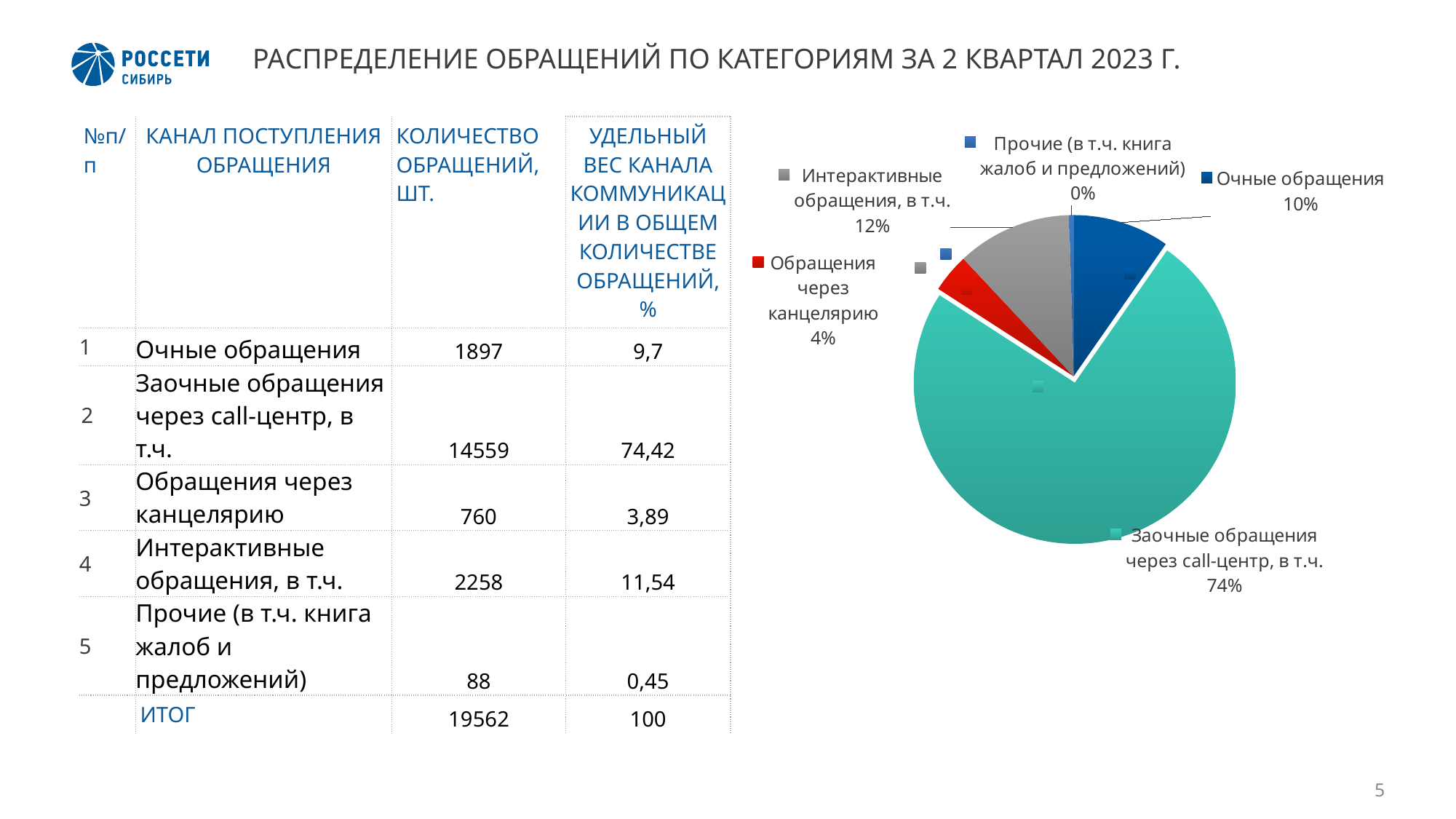
What is the value shown for "Интерактивные обращения, в т.ч." in the pie chart? 12% Which slice is larger: "Интерактивные обращения, в т.ч." or "Очные обращения"? Интерактивные обращения, в т.ч. What colour is the "Обращения через канцелярию" slice in the pie chart? red How many slices does the pie chart have? 5 Which category has the smallest slice of the pie chart? Прочие (в т.ч. книга жалоб и предложений) What kind of chart is shown on the slide? pie chart Which category has the largest slice of the pie chart? Заочные обращения через call-центр, в т.ч. What is the value shown for "Обращения через канцелярию" in the pie chart? 4% What share of the pie does "Очные обращения" have? 10% What is the difference in percentage points between the "Заочные обращения через call-центр, в т.ч." slice and the "Очные обращения" slice? 64% What is the value shown for "Прочие (в т.ч. книга жалоб и предложений)" in the pie chart? 0% What share of the pie does "Заочные обращения через call-центр, в т.ч." have? 74%